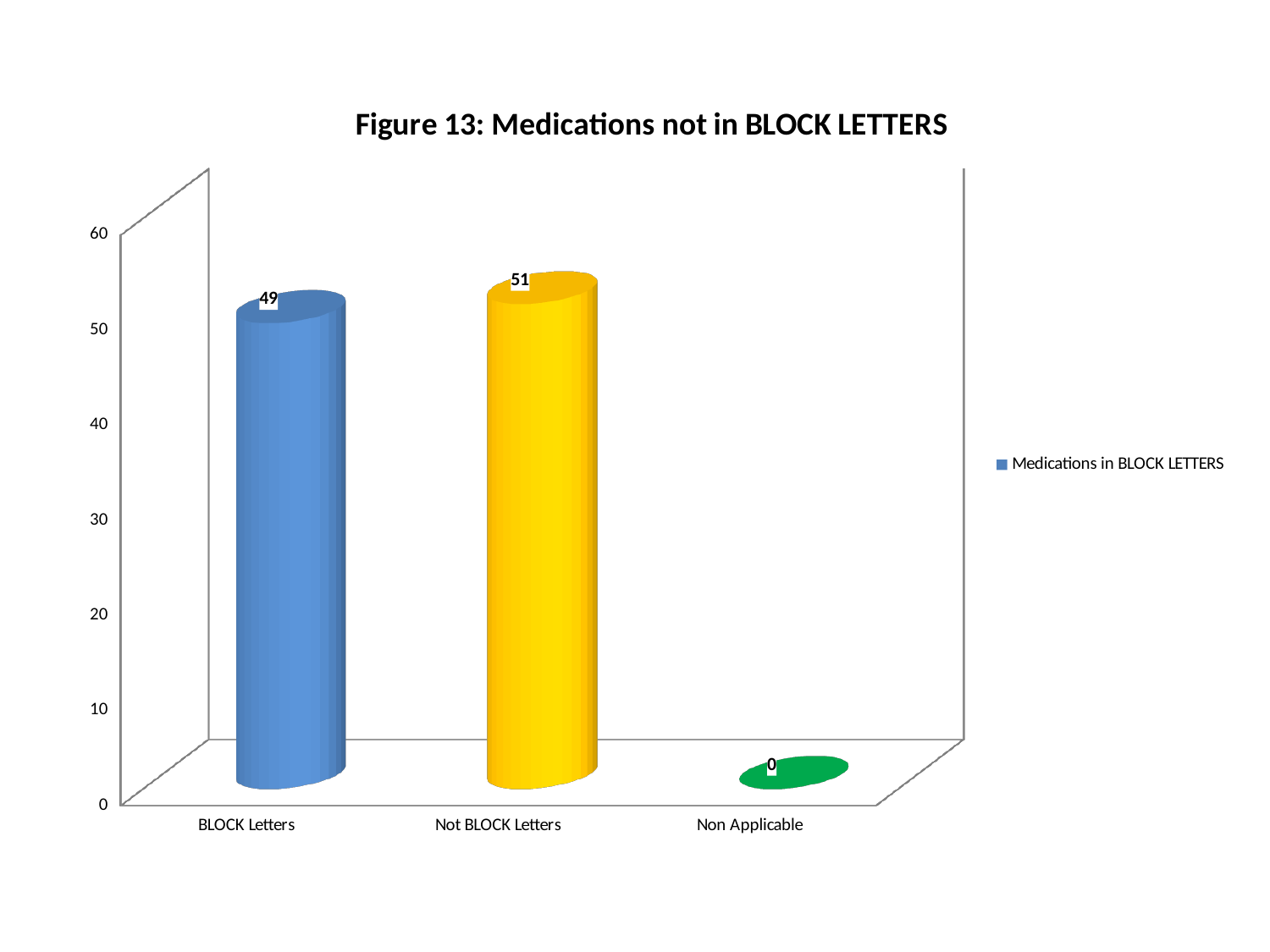
Which category has the lowest value? Non Applicable Which is larger, the value for BLOCK Letters or the value for Non Applicable? BLOCK Letters How many categories are shown on the x axis? 3 What is the difference between the values for Not BLOCK Letters and BLOCK Letters? 2 Is the value for BLOCK Letters greater or less than 40? greater How many series does the legend list? 1 What is the value for BLOCK Letters? 49 What is the title of the chart? Figure 13: Medications not in BLOCK LETTERS What kind of chart is shown on the slide? bar chart What is the value for Non Applicable? 0 Which category has the highest value? Not BLOCK Letters What is the value for Not BLOCK Letters? 51